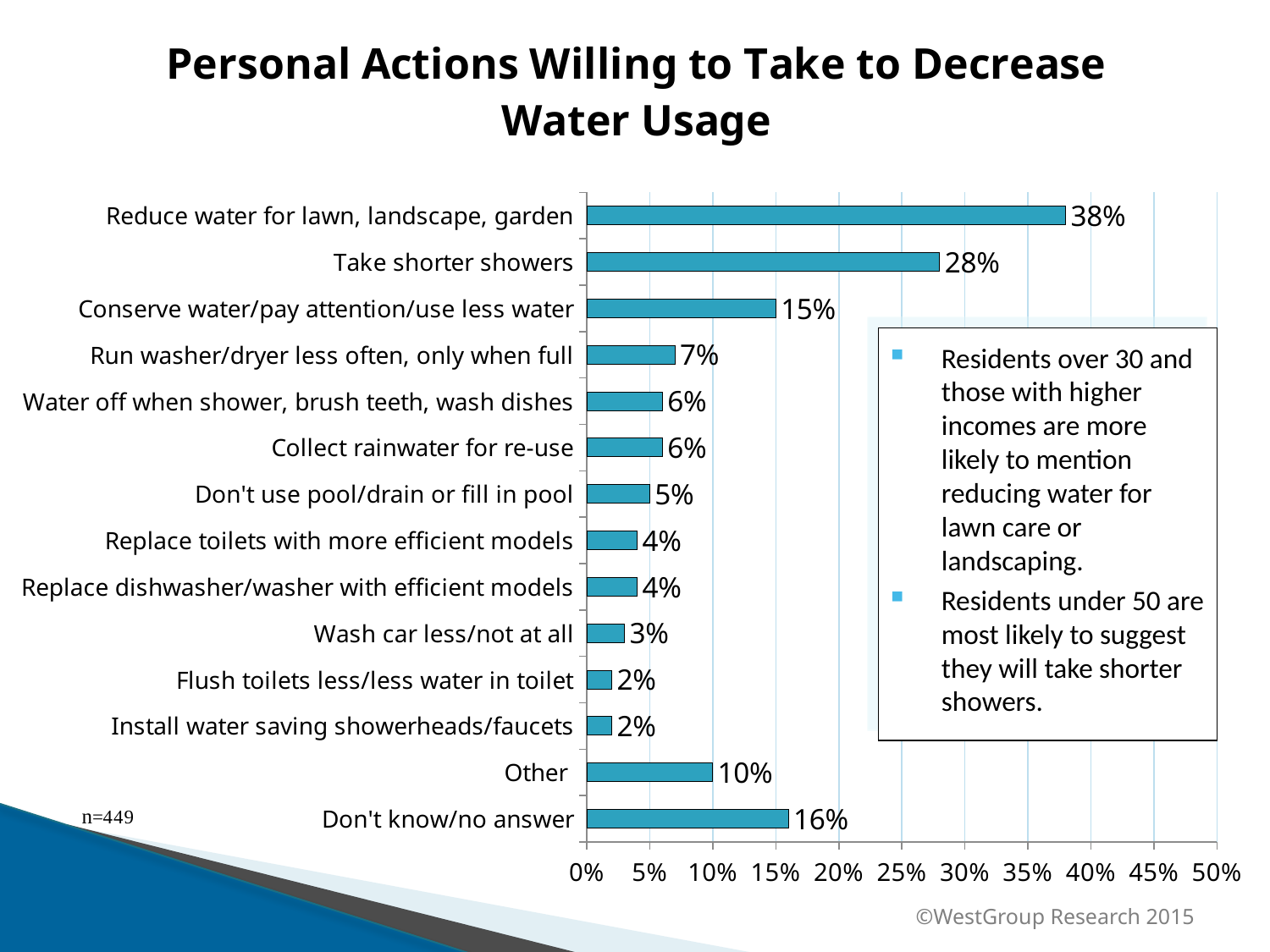
How many categories are plotted in the chart? 14 What percentage is shown for 'Don't know/no answer'? 16% Which is larger: 'Conserve water/pay attention/use less water' or 'Run washer/dryer less often, only when full'? Conserve water/pay attention/use less water Which category has the highest value? Reduce water for lawn, landscape, garden What percentage of respondents are willing to reduce water for lawn, landscape, garden? 38% What is the value for 'Wash car less/not at all'? 3% What is the title of the chart? Personal Actions Willing to Take to Decrease Water Usage What kind of chart is shown on the slide? Bar chart What is the value for 'Take shorter showers'? 28% What is the difference between 'Reduce water for lawn, landscape, garden' and 'Take shorter showers'? 10% What is the value for 'Other'? 10% Is the value for 'Take shorter showers' greater or less than 25%? greater